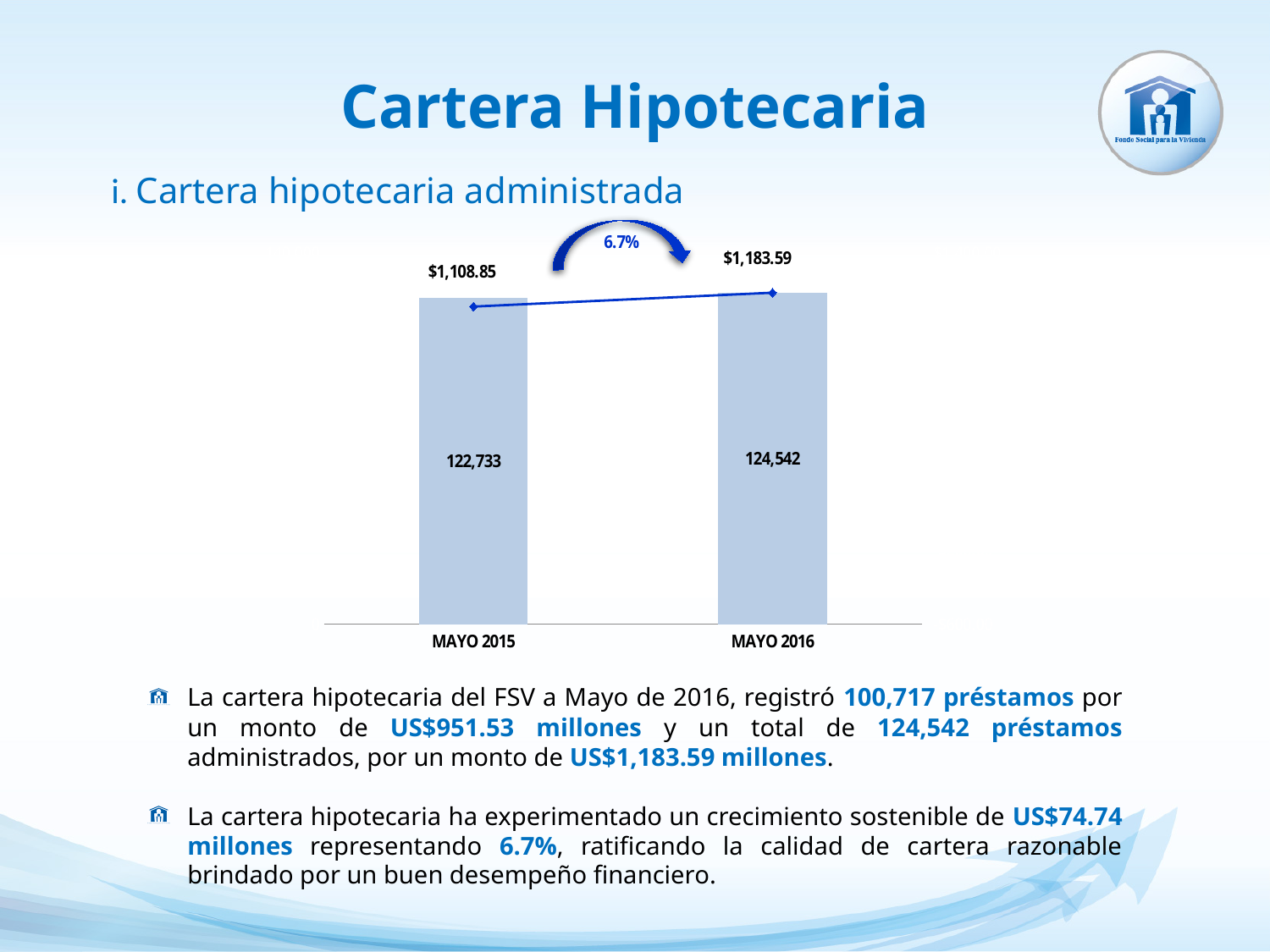
How many periods are shown on the x axis of the chart? 2 Which period has the lower amount on the line, MAYO 2015 or MAYO 2016? MAYO 2015 What percentage growth is shown by the arrow between the two periods? 6.7% What is the difference in the number of loans between MAYO 2016 and MAYO 2015? 1,809 What is the number of loans shown on the bar for MAYO 2015? 122,733 What is the difference between the amounts labelled for MAYO 2016 and MAYO 2015? $74.74 What amount is labelled on the line point for MAYO 2015? $1,108.85 What is the number of loans shown on the bar for MAYO 2016? 124,542 What amount is labelled on the line point for MAYO 2016? $1,183.59 Which period has the higher number of loans, MAYO 2015 or MAYO 2016? MAYO 2016 Do the values rise or fall from MAYO 2015 to MAYO 2016? rise What kind of chart is shown on the slide? bar chart with a line